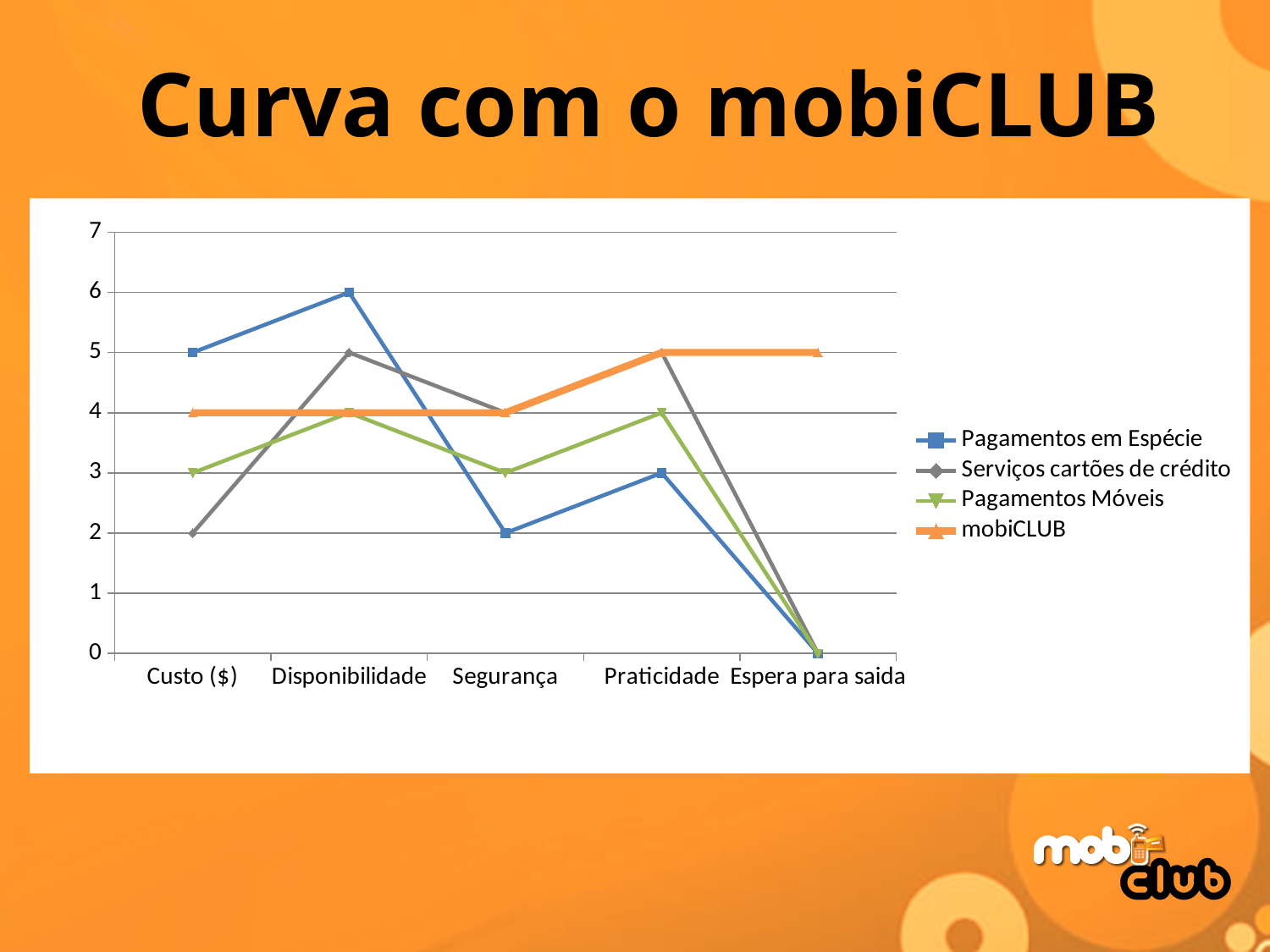
What is the difference between Pagamentos em Espécie and mobiCLUB at Disponibilidade? 2 What is the value for Pagamentos em Espécie at Disponibilidade? 6 How many categories are shown on the x axis? 5 What is the title of the slide? Curva com o mobiCLUB What is the value for Pagamentos Móveis at Segurança? 3 Which series has the lowest value at Custo ($)? Serviços cartões de crédito What is the value for mobiCLUB at Espera para saida? 5 How many series does the legend list? 4 Which is larger at Segurança: Pagamentos em Espécie or Serviços cartões de crédito? Serviços cartões de crédito What is the value for Serviços cartões de crédito at Custo ($)? 2 Which series has the highest value at Espera para saida? mobiCLUB What kind of chart is shown on the slide? Line chart